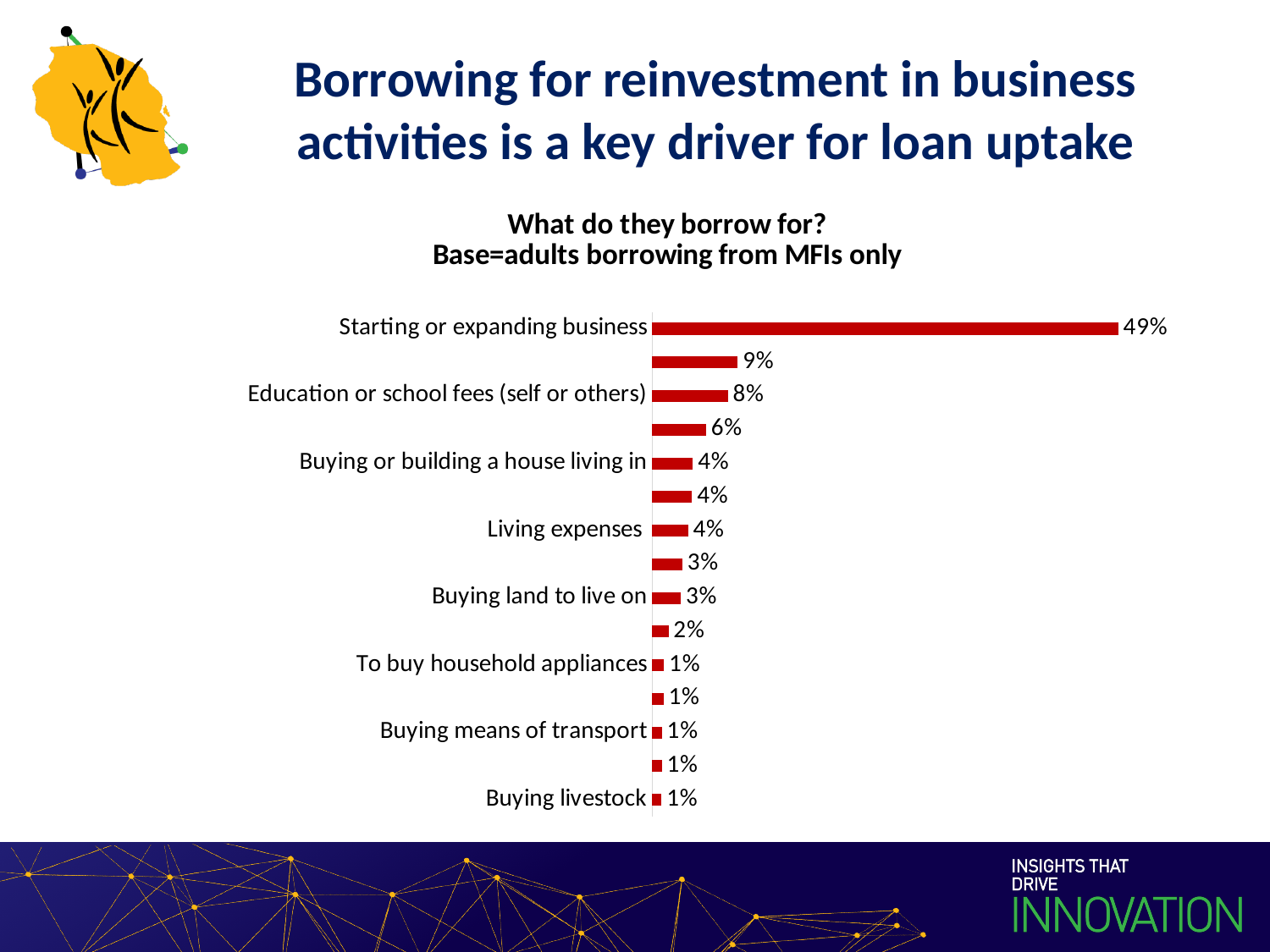
What kind of chart is shown on the slide? bar chart How many bars are plotted in the chart? 15 What is the value for Buying livestock? 1% What is the value for Buying land to live on? 3% What percentage of adults borrowing from MFIs borrow for starting or expanding business? 49% What is the title of the chart? What do they borrow for? Base=adults borrowing from MFIs only Which is larger: the value for Buying or building a house living in or the value for To buy household appliances? Buying or building a house living in What is the value for Education or school fees (self or others)? 8% Which is larger: the value for Education or school fees (self or others) or the value for Living expenses? Education or school fees (self or others) Which category has the highest value? Starting or expanding business What is the difference between the values for Starting or expanding business and Education or school fees (self or others)? 41 percentage points What is the value for Living expenses? 4%